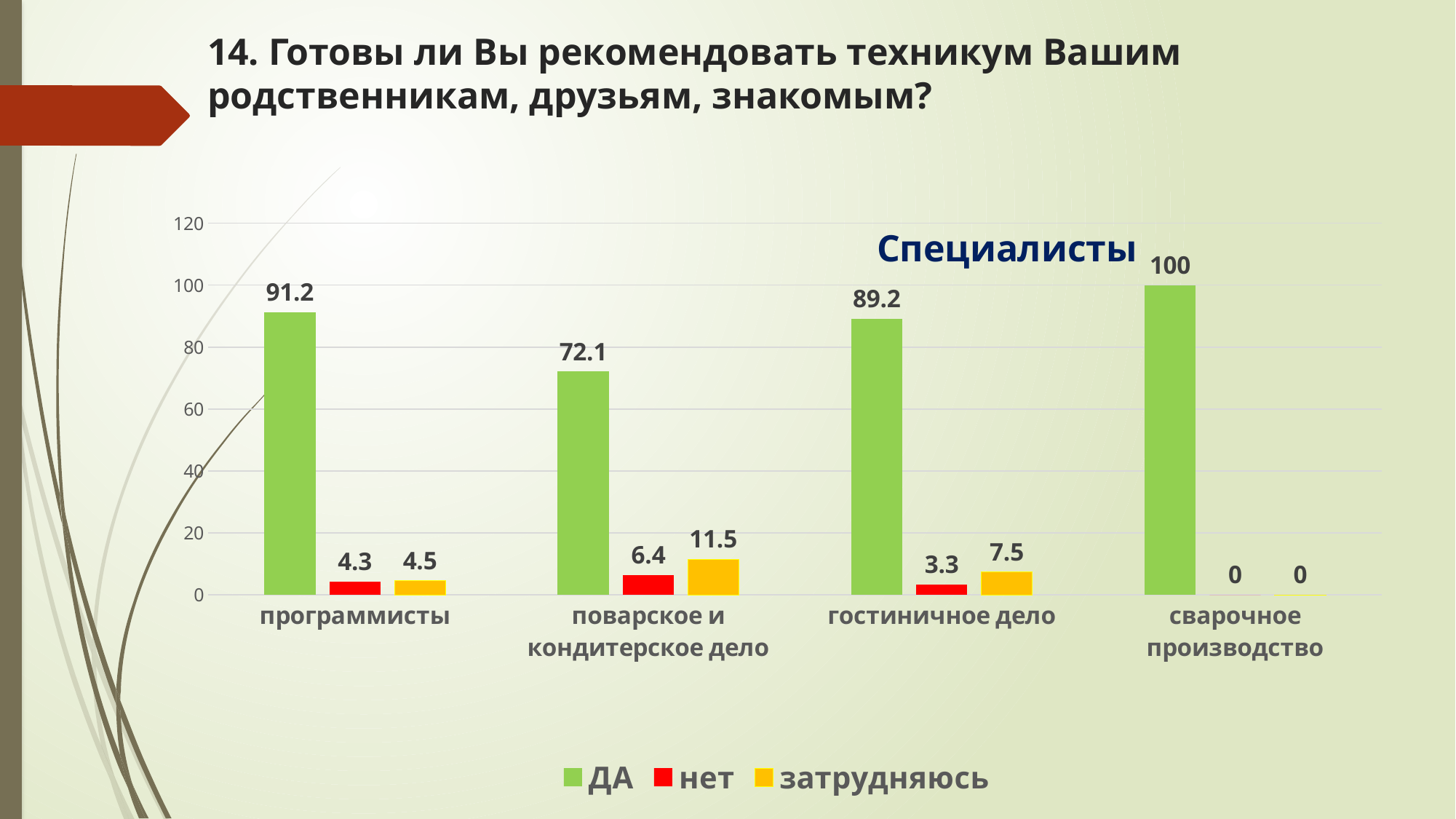
What is the value for ДА for программисты? 91.2 How many categories are shown on the x axis? 4 What kind of chart is shown on the slide? bar chart How many series does the legend list? 3 What is the value for затрудняюсь for сварочное производство? 0 What is the value for затрудняюсь for поварское и кондитерское дело? 11.5 Which category has the lowest value for ДА? поварское и кондитерское дело Which category has the highest value for ДА? сварочное производство What is the value for нет for гостиничное дело? 3.3 What is the difference between the ДА values for программисты and поварское и кондитерское дело? 19.1 Which is larger: the нет value for поварское и кондитерское дело or the нет value for программисты? поварское и кондитерское дело What colour are the bars for the ДА series? green